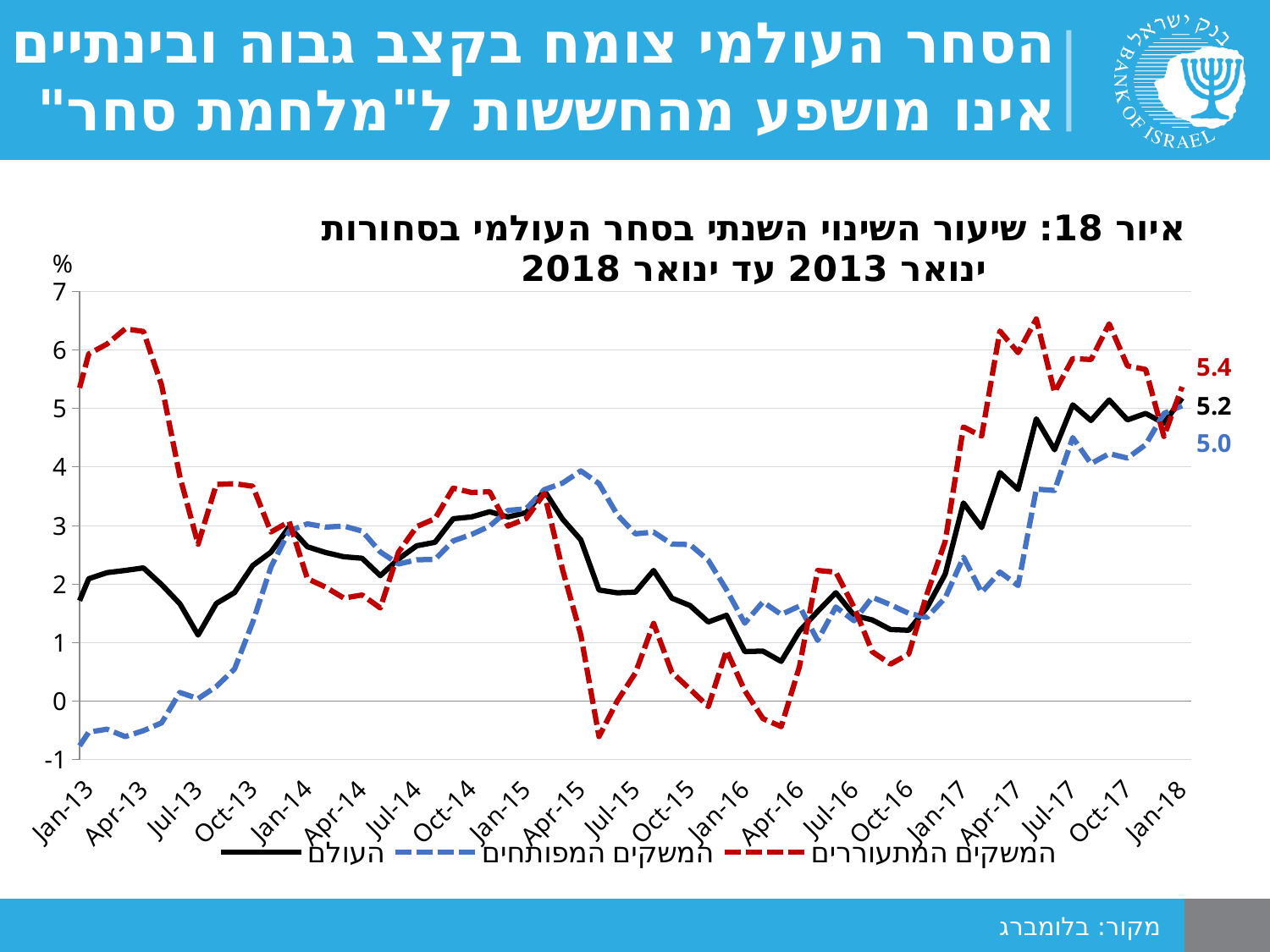
Which series has the lowest value at Jan-18? המשקים המפותחים Is the value for המשקים המתעוררים at Apr-13 greater or less than 6? greater At Jan-18, which is larger: the value for העולם or the value for המשקים המפותחים? העולם What is the value labelled for המשקים המתעוררים (emerging markets) at the end of the series in Jan-18? 5.4 What is the value labelled for העולם (world) at the end of the series in Jan-18? 5.2 Does the value for העולם rise or fall between Jan-16 and Jan-18? rise Is the value for המשקים המפותחים at Jan-13 greater or less than 0? less What is the value labelled for המשקים המפותחים (developed markets) at the end of the series in Jan-18? 5.0 How many series does the legend list? 3 Which series has the highest value at Jan-18? המשקים המתעוררים What is the difference between the Jan-18 values of המשקים המתעוררים and המשקים המפותחים? 0.4 What kind of chart is shown on the slide? line chart